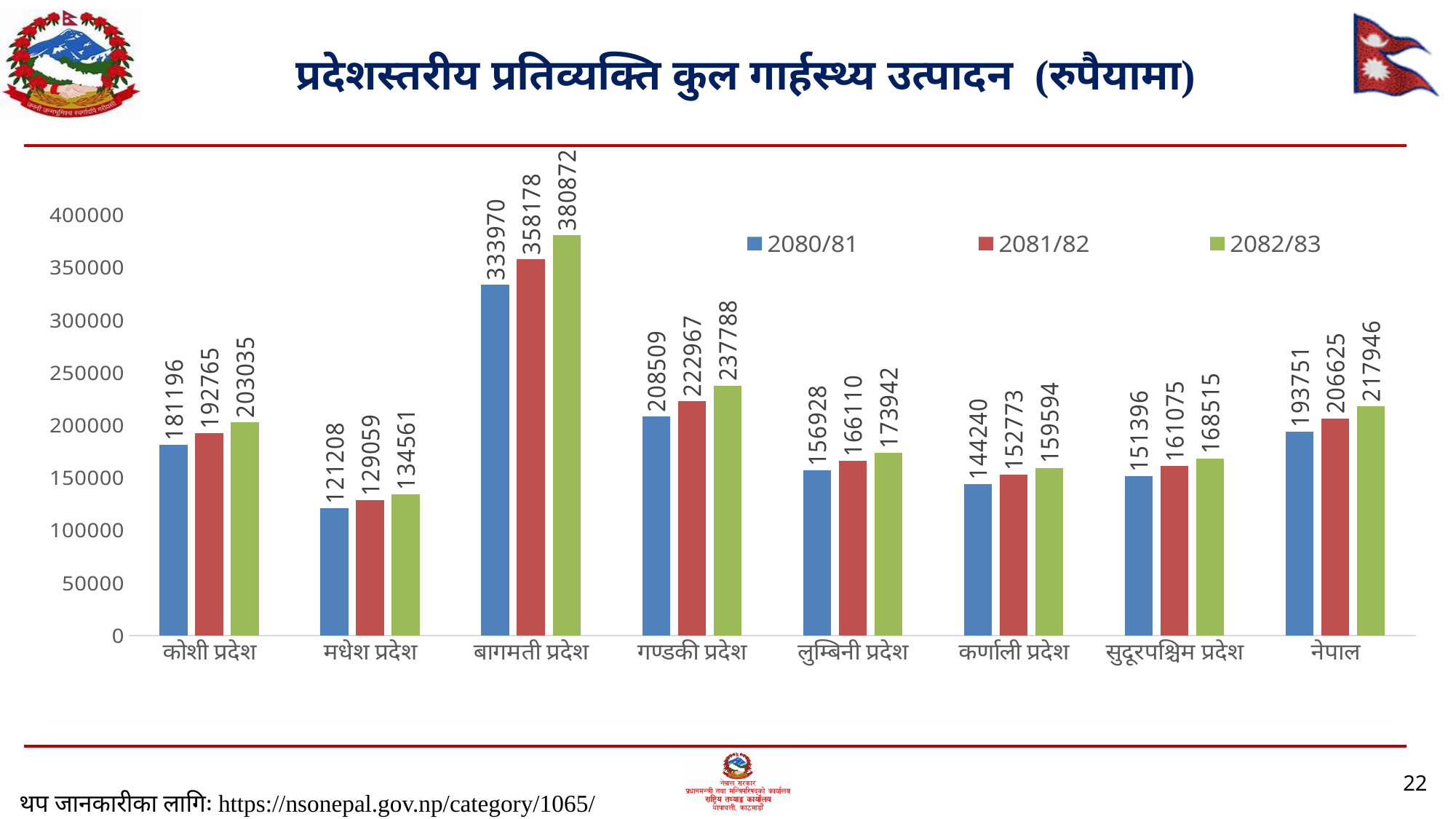
How many series does the legend list? 3 What kind of chart is shown on the slide? bar chart Is the 2082/83 value for गण्डकी प्रदेश greater or less than 200000? greater For लुम्बिनी प्रदेश, do the values rise or fall from 2080/81 to 2082/83? rise Which category has the highest value in the 2082/83 series? बागमती प्रदेश What is the value for बागमती प्रदेश in the 2082/83 series? 380872 What is the value for मधेश प्रदेश in the 2080/81 series? 121208 Which is larger: the 2081/82 value for कर्णाली प्रदेश or the 2081/82 value for सुदूरपश्चिम प्रदेश? सुदूरपश्चिम प्रदेश How many categories are shown on the x axis? 8 What is the value for नेपाल in the 2081/82 series? 206625 Which category has the lowest value in the 2080/81 series? मधेश प्रदेश What is the difference between the 2082/83 and 2080/81 values for कोशी प्रदेश? 21839